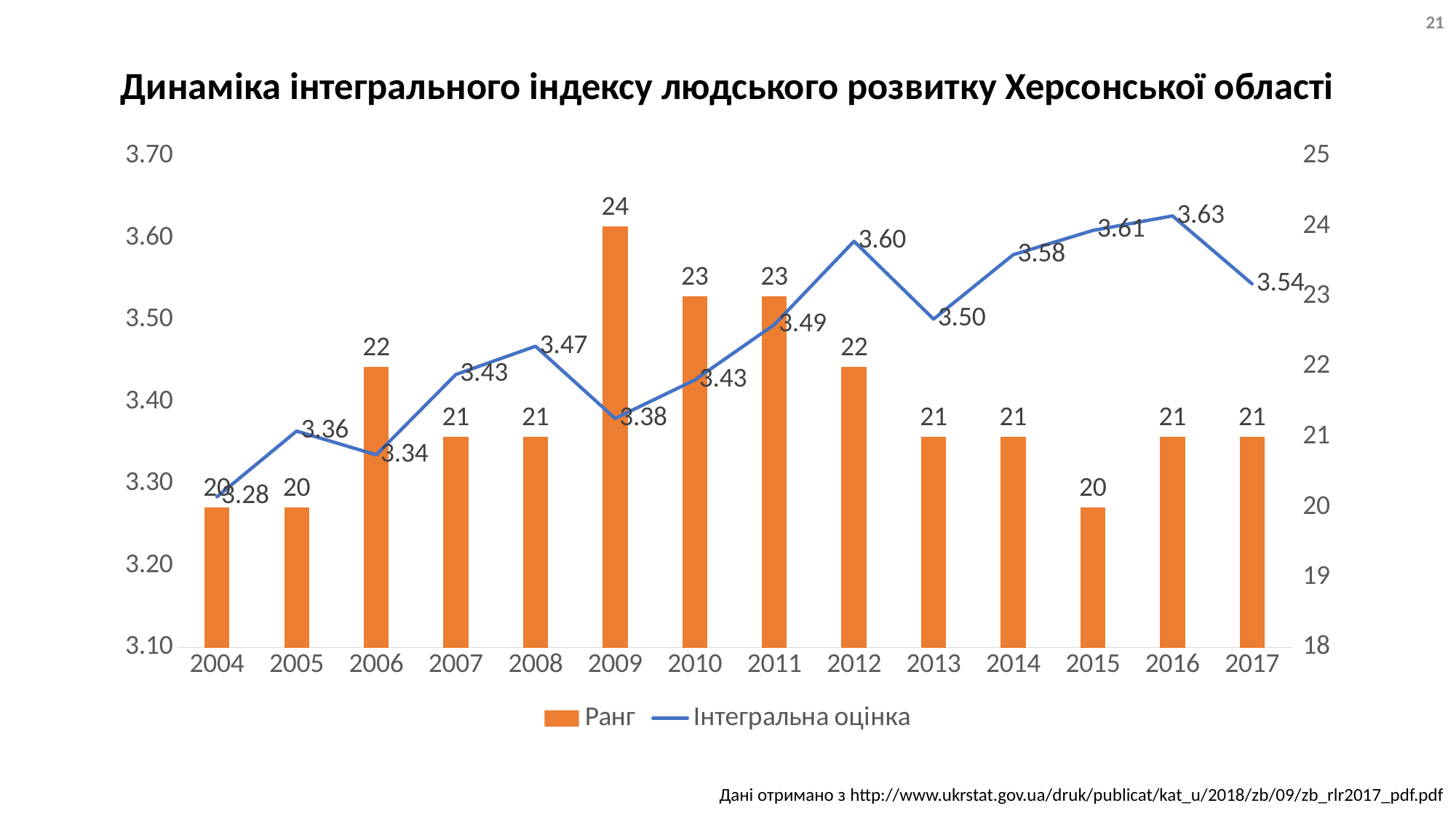
What is the difference between the Інтегральна оцінка values for 2016 and 2017? 0.09 How many series does the legend list? 2 Which year has the lowest Інтегральна оцінка value? 2004 Which year has the highest Ранг value? 2009 What kind of chart is this? Combined bar and line chart What is the difference between the Ранг values for 2009 and 2015? 4 What is the value of Ранг for 2009? 24 Which series is shown as orange bars? Ранг How many years are shown on the x axis? 14 What is the value of Інтегральна оцінка for 2016? 3.63 Which is larger, the Інтегральна оцінка for 2012 or for 2013? 2012 What is the value of Інтегральна оцінка for 2004? 3.28